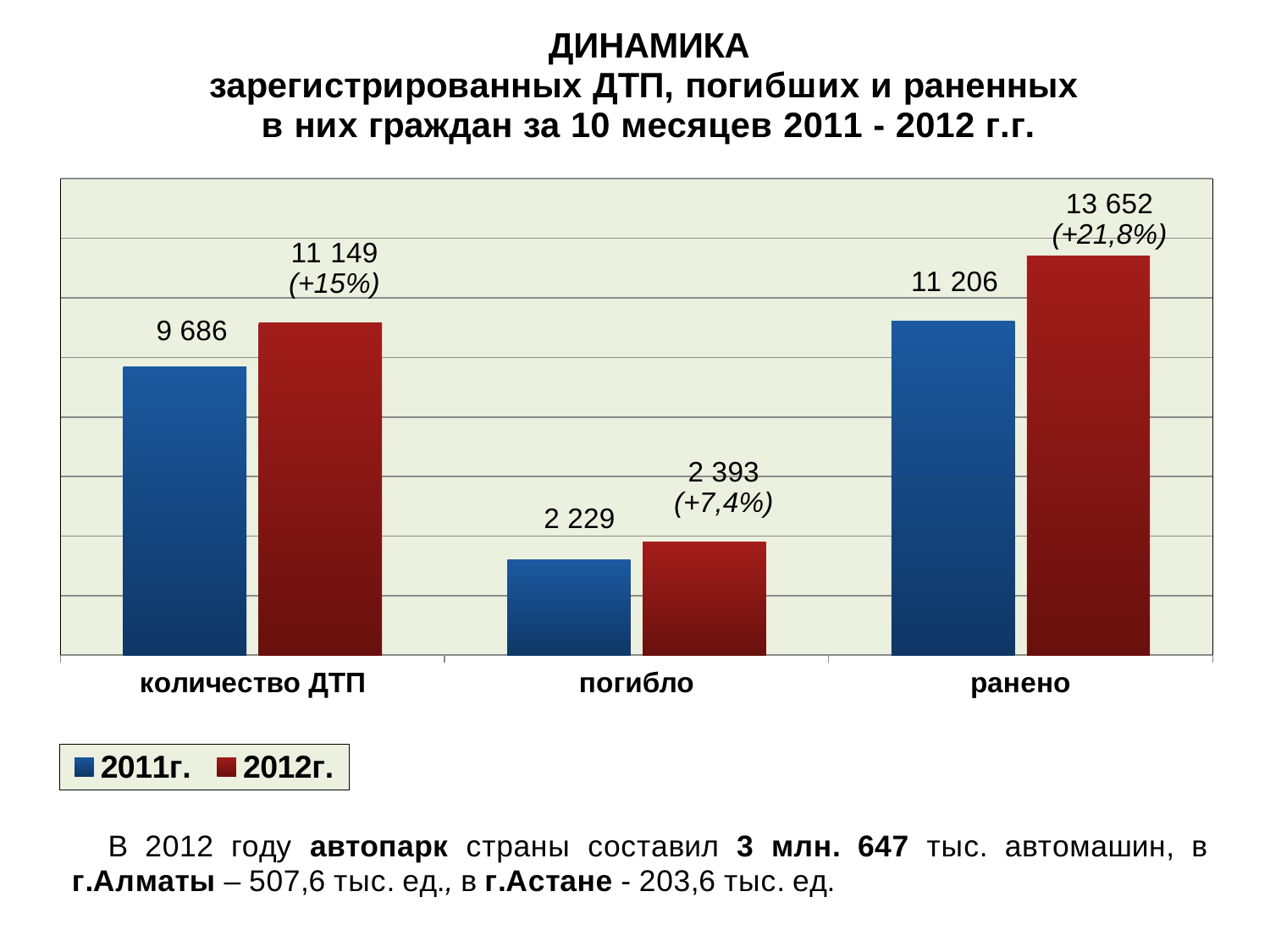
What kind of chart is shown on the slide? bar chart What is the value for 2011г. in the ранено category? 11 206 What is the difference between the 2012г. and 2011г. values in the ранено category? 2 446 How many series does the legend list? 2 What is the value for 2012г. in the ранено category? 13 652 What is the value for 2011г. in the количество ДТП category? 9 686 Which is larger in the погибло category: the 2011г. value or the 2012г. value? 2012г. What is the value for 2012г. in the погибло category? 2 393 How many categories are shown on the x axis? 3 Which category has the lowest value for the 2011г. series? погибло Which category has the highest value for the 2012г. series? ранено What is the difference between the 2012г. and 2011г. values in the количество ДТП category? 1 463